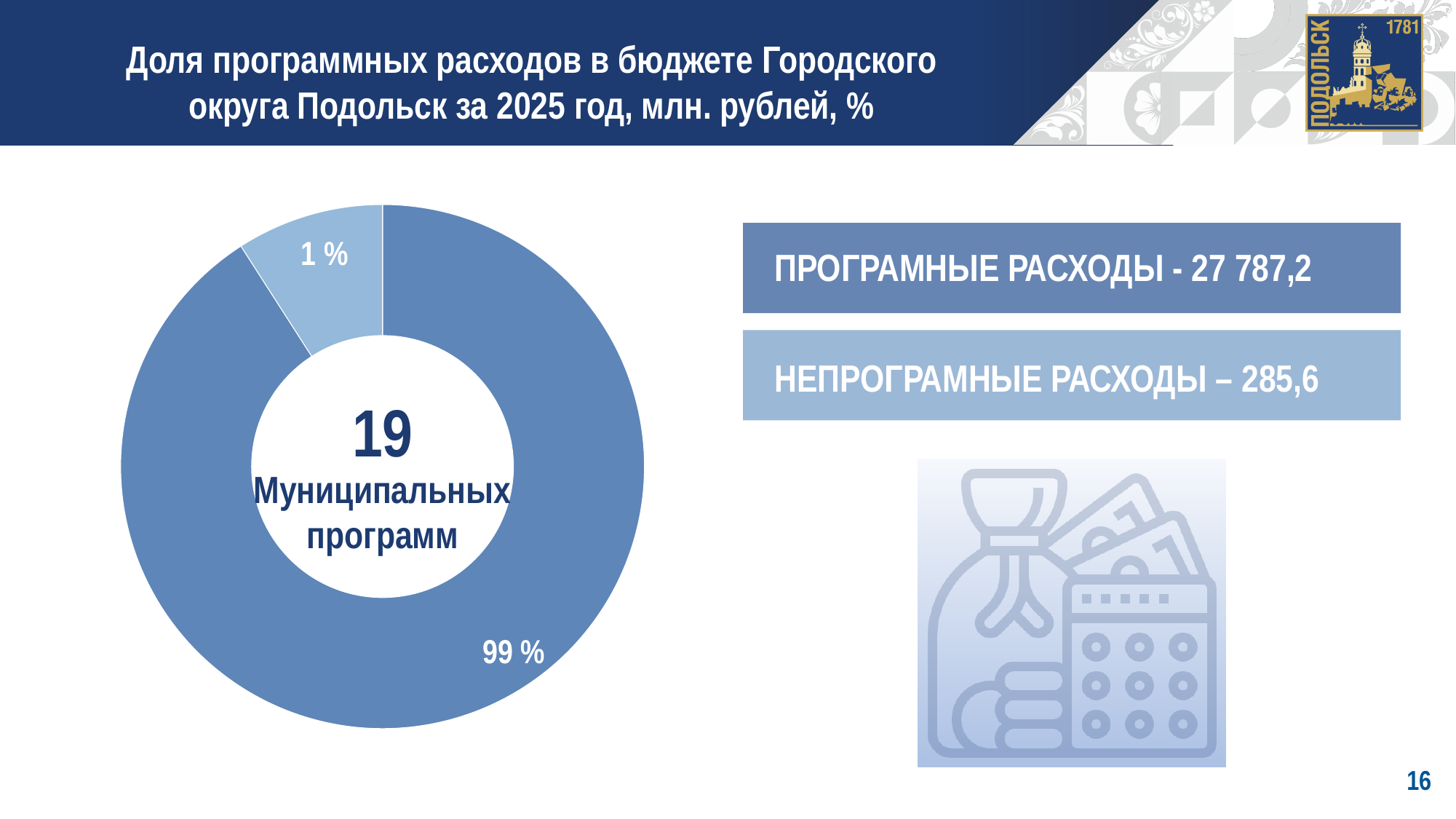
What is the difference in million rubles between программные расходы and непрограммные расходы? 27 501,6 What is the title of the slide? Доля программных расходов в бюджете Городского округа Подольск за 2025 год, млн. рублей, % What share of the pie does the light blue slice (непрограммные расходы) represent? 1 % Which category has the smallest share of the pie? Непрограммные расходы Which is larger: программные расходы or непрограммные расходы? Программные расходы What number is shown in the centre of the donut chart? 19 Муниципальных программ What share of the pie does the dark blue slice (программные расходы) represent? 99 % What is the value of программные расходы in million rubles? 27 787,2 How many slices does the pie chart have? 2 Which category has the largest share of the pie? Программные расходы What is the value of непрограммные расходы in million rubles? 285,6 What kind of chart is shown on the slide? Pie chart (donut)